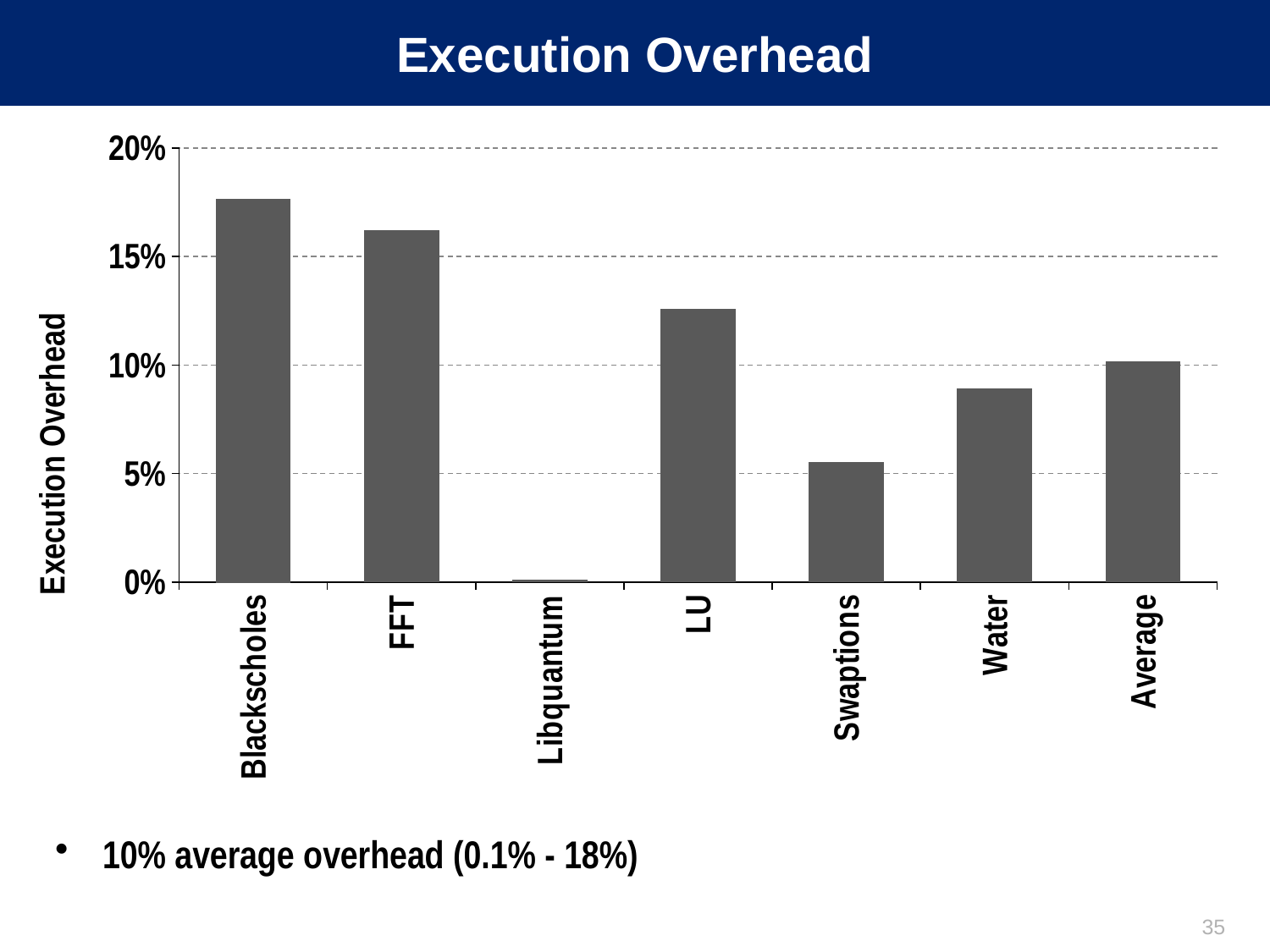
What is the title of the chart's y axis? Execution Overhead Is the execution overhead for Blackscholes greater or less than 15%? greater How many categories are shown on the x axis of the chart? 7 Is the execution overhead for LU greater or less than 10%? greater Is the execution overhead for Water greater or less than 10%? less Which has a higher execution overhead, FFT or LU? FFT Which category has the highest execution overhead? Blackscholes Which category has the lowest execution overhead? Libquantum Which has a higher execution overhead, Water or Swaptions? Water What is the title of the slide? Execution Overhead What kind of chart is shown on the slide? bar chart